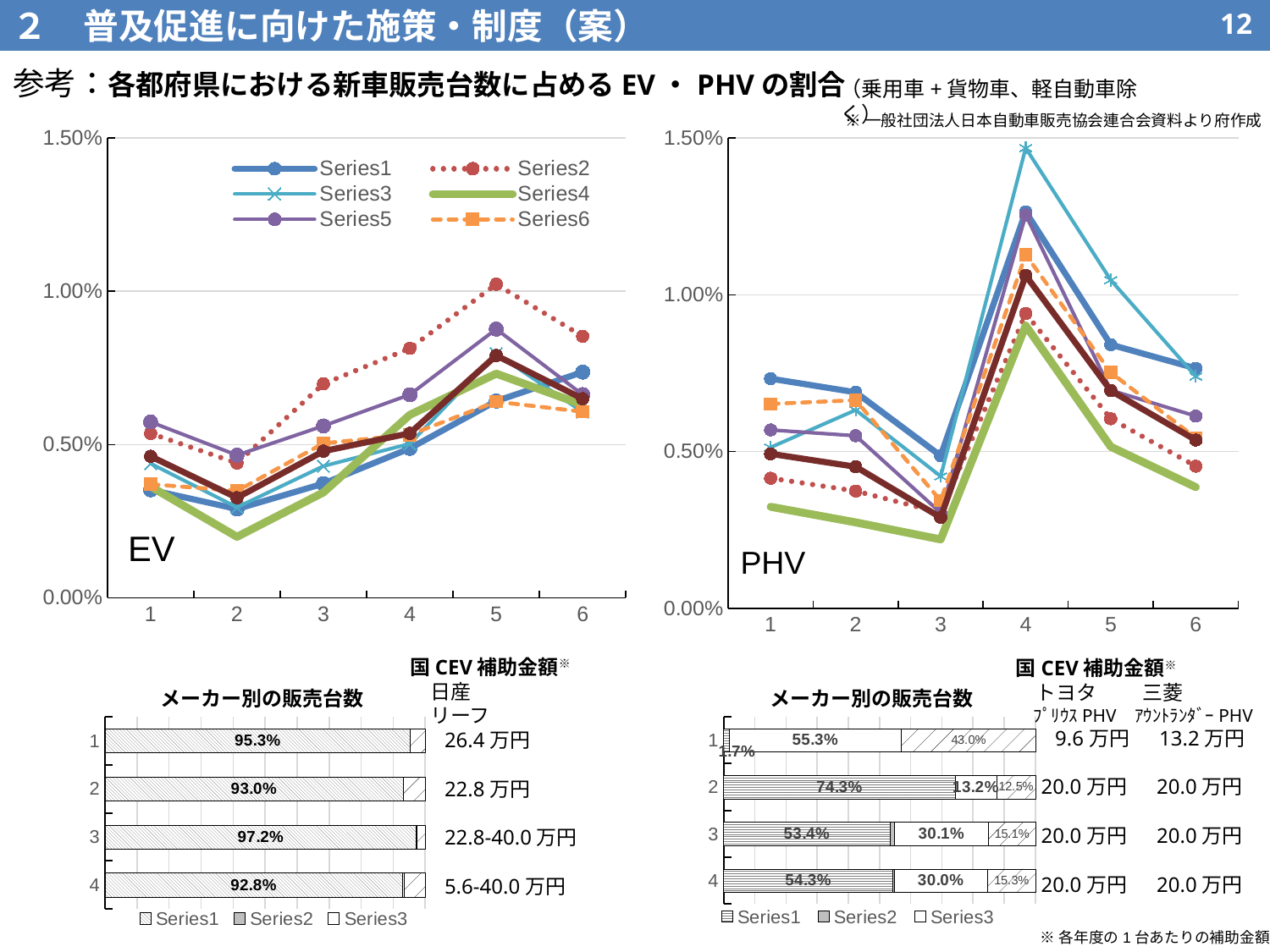
In the bottom-left bar chart (メーカー別の販売台数), what is the difference between the Series1 values for category 1 and category 2? 2.3% In the EV line chart, is the value of Series4 at x = 2 greater or less than 0.50%? less In the bottom-left bar chart (メーカー別の販売台数), which category has the highest Series1 value? 3 How many series does the legend of the EV line chart list? 6 In the bottom-right bar chart (メーカー別の販売台数), which is larger for category 4: the Series1 value or the Series2 value? Series1 In the bottom-left bar chart (メーカー別の販売台数), what is the Series1 value for category 3? 97.2% In the EV line chart, is the value of Series2 at x = 5 greater or less than 1.00%? greater What kind of chart is the bottom-left chart titled メーカー別の販売台数? bar chart In the bottom-right bar chart (メーカー別の販売台数), what is the Series1 value for category 2? 74.3% In the bottom-left bar chart (メーカー別の販売台数), which category has the lowest Series1 value? 4 In the bottom-right bar chart (メーカー別の販売台数), what is the Series2 value for category 3? 30.1% How many series does the legend of the bottom-left bar chart (メーカー別の販売台数) list? 3